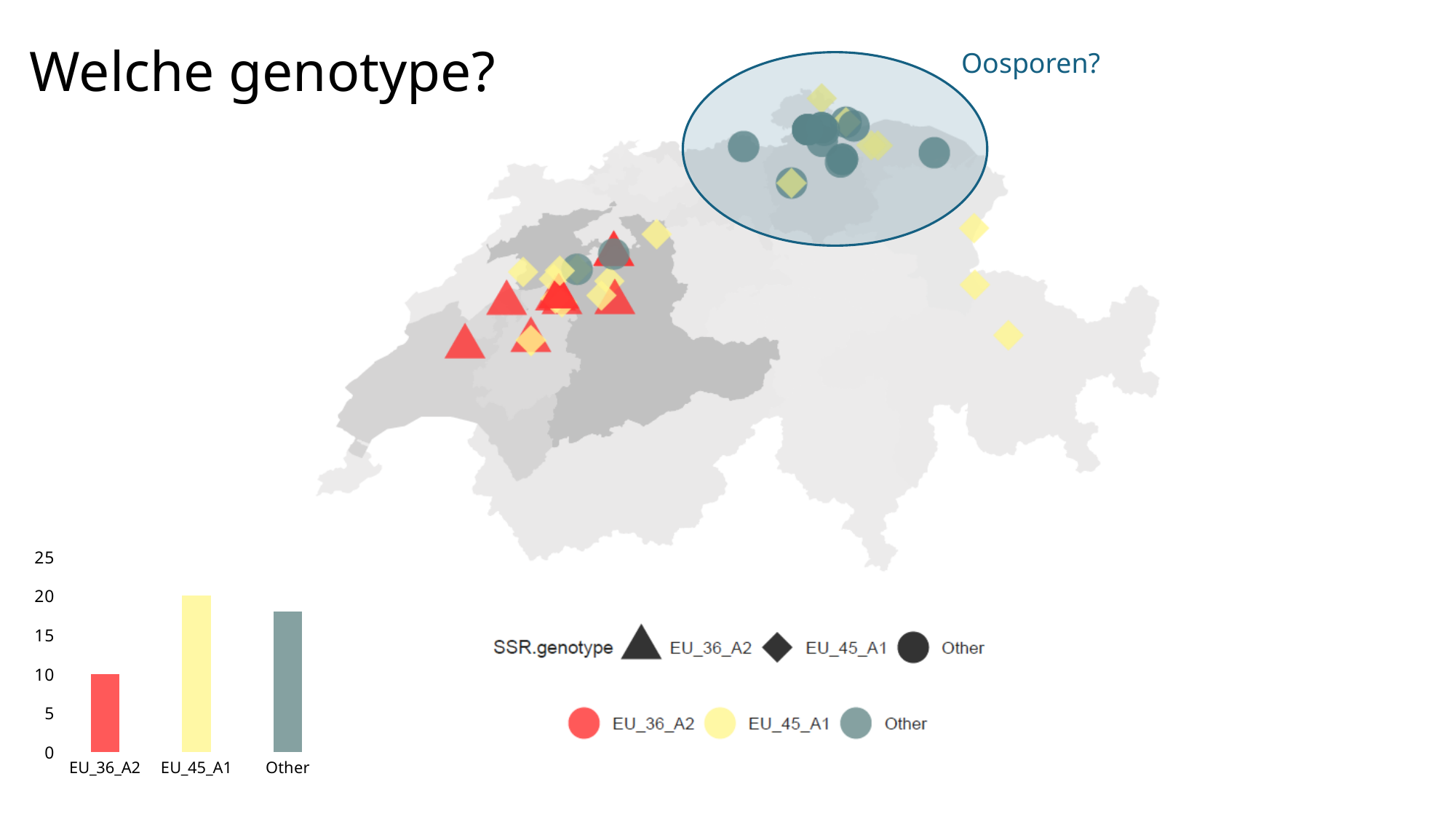
What kind of chart is shown at the bottom left of the slide? bar chart In the bar chart at the bottom left, is the value for Other greater or less than 20? less In the bar chart at the bottom left, what is the value for EU_36_A2? 10 In the bar chart at the bottom left, which category has the highest value? EU_45_A1 According to the SSR.genotype legend on the map, which shape represents EU_36_A2? triangle In the bar chart at the bottom left, what is the value for EU_45_A1? 20 In the bar chart at the bottom left, what is the difference between the values for EU_45_A1 and EU_36_A2? 10 In the bar chart at the bottom left, what colour is the bar for EU_45_A1? yellow In the bar chart at the bottom left, is the value for Other greater or less than 15? greater How many categories does the bar chart at the bottom left show? 3 In the bar chart at the bottom left, which category has the lowest value? EU_36_A2 In the bar chart at the bottom left, which is larger: the value for Other or the value for EU_36_A2? Other